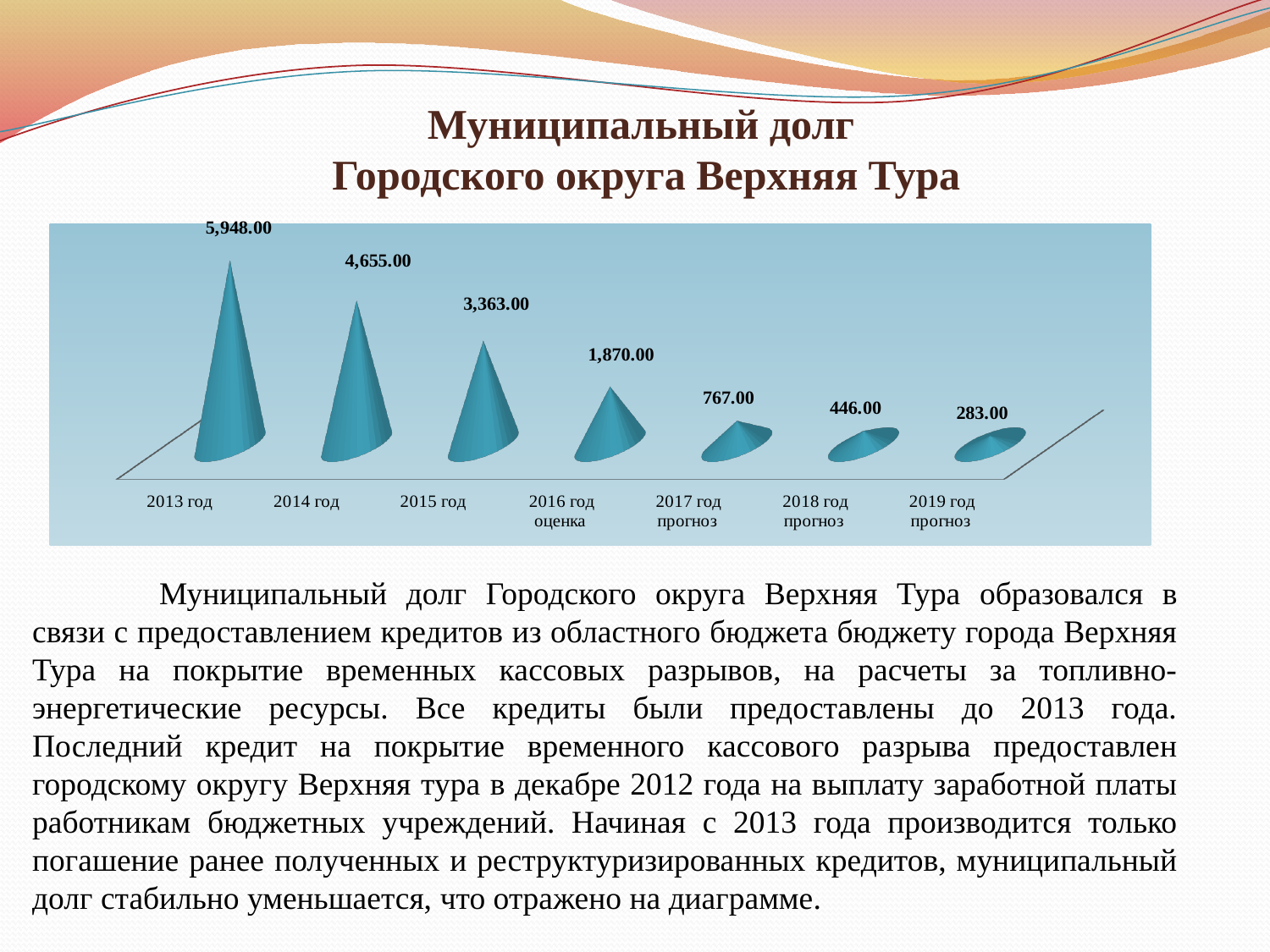
How many years (categories) are plotted on the chart? 7 What is the difference between the values for 2017 год прогноз and 2018 год прогноз? 321.00 What is the title of the slide above the chart? Муниципальный долг Городского округа Верхняя Тура Which year has the lowest value on the chart? 2019 год прогноз What is the difference between the values for 2013 год and 2014 год? 1,293.00 What is the value shown for 2016 год оценка? 1,870.00 What kind of chart is shown on the slide? Bar chart Do the values rise or fall from 2013 год to 2019 год прогноз? Fall What is the value shown for 2019 год прогноз? 283.00 What is the value shown for 2013 год? 5,948.00 Which is larger, the value for 2015 год or the value for 2016 год оценка? 2015 год Which year has the highest value on the chart? 2013 год